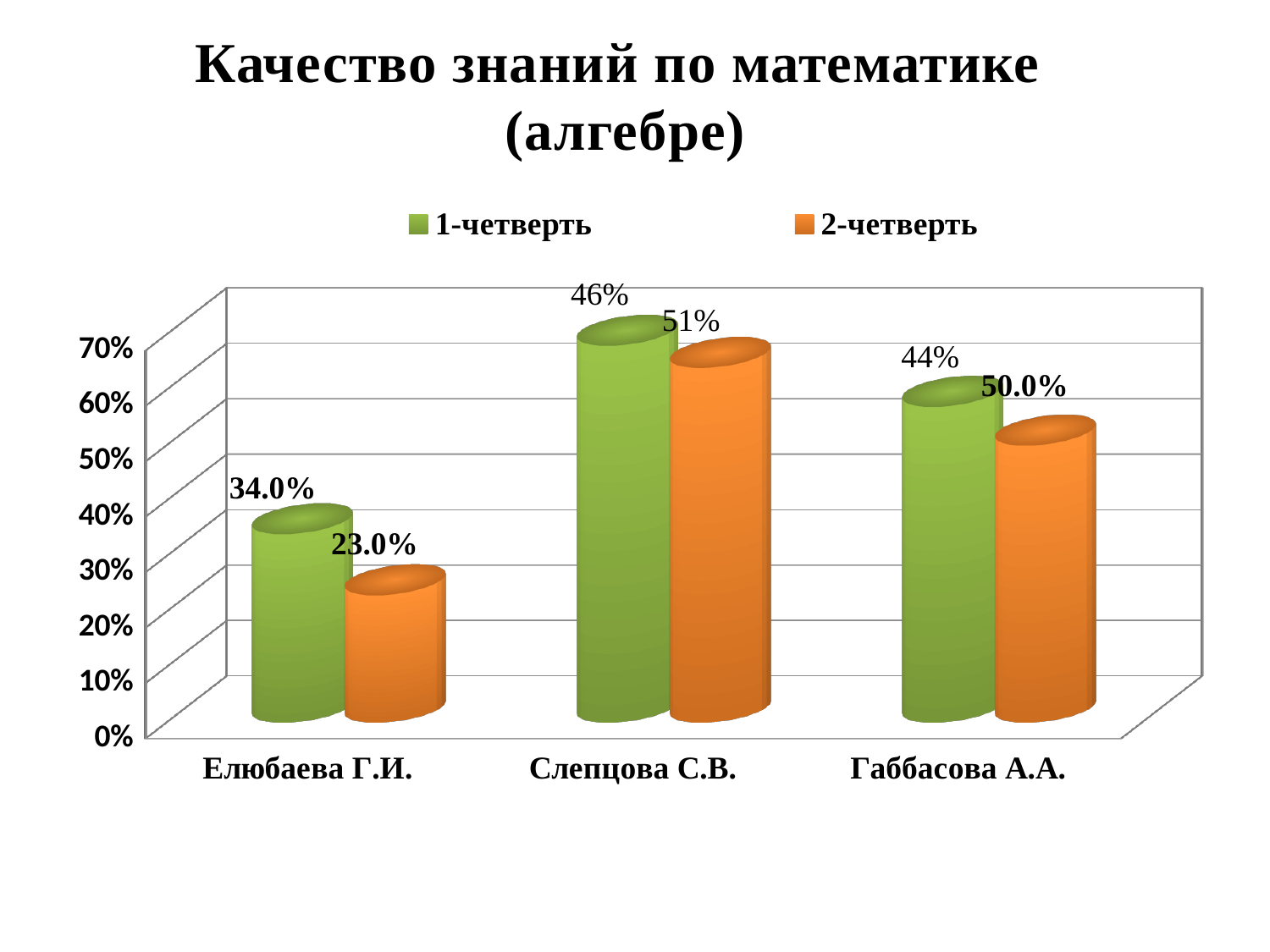
What is the difference between the 2-четверть and 1-четверть values for Слепцова С.В.? 5% What is the value for Елюбаева Г.И. in the 2-четверть series? 23.0% What is the difference between the 1-четверть and 2-четверть values for Елюбаева Г.И.? 11.0% What is the value for Елюбаева Г.И. in the 1-четверть series? 34.0% How many teachers are shown on the x axis? 3 Which teacher has the highest value in the 2-четверть series? Слепцова С.В. What is the value for Слепцова С.В. in the 2-четверть series? 51% How many series does the legend list? 2 What is the value for Габбасова А.А. in the 1-четверть series? 44% What kind of chart is shown on the slide? Bar chart Which teacher has the lowest value in the 1-четверть series? Елюбаева Г.И.